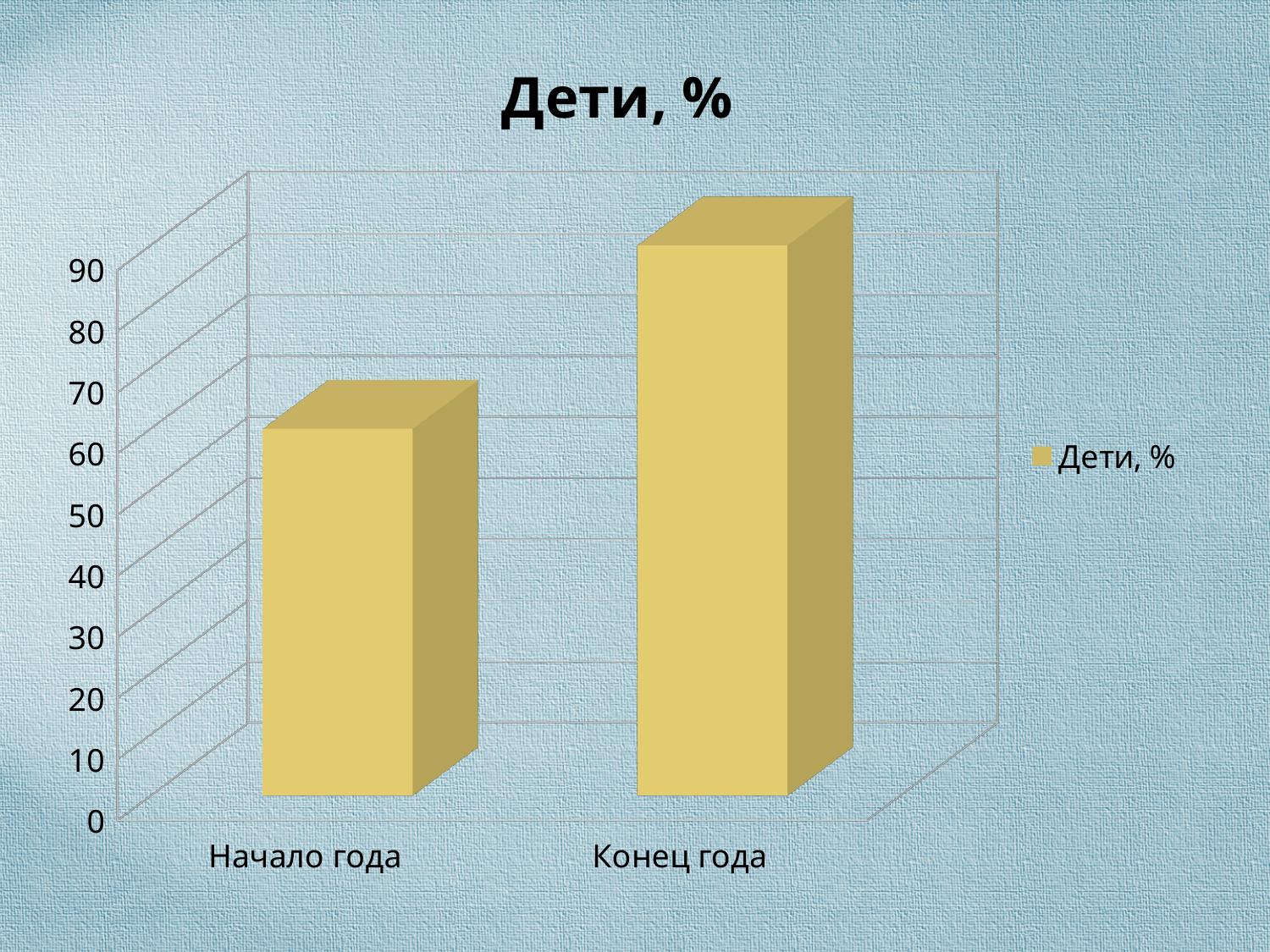
Is the value for Начало года greater or less than 70? less What kind of chart is shown on the slide? bar chart What is the title of the chart? Дети, % Which is larger, the value for Начало года or the value for Конец года? Конец года Which category has the highest value? Конец года Is the value for Конец года greater or less than 80? greater How many categories are shown on the x axis of the chart? 2 Do the values rise or fall from Начало года to Конец года? rise Is the value for Начало года greater or less than 50? greater How many series does the legend list? 1 What series name is shown in the legend? Дети, % Which category has the lowest value? Начало года